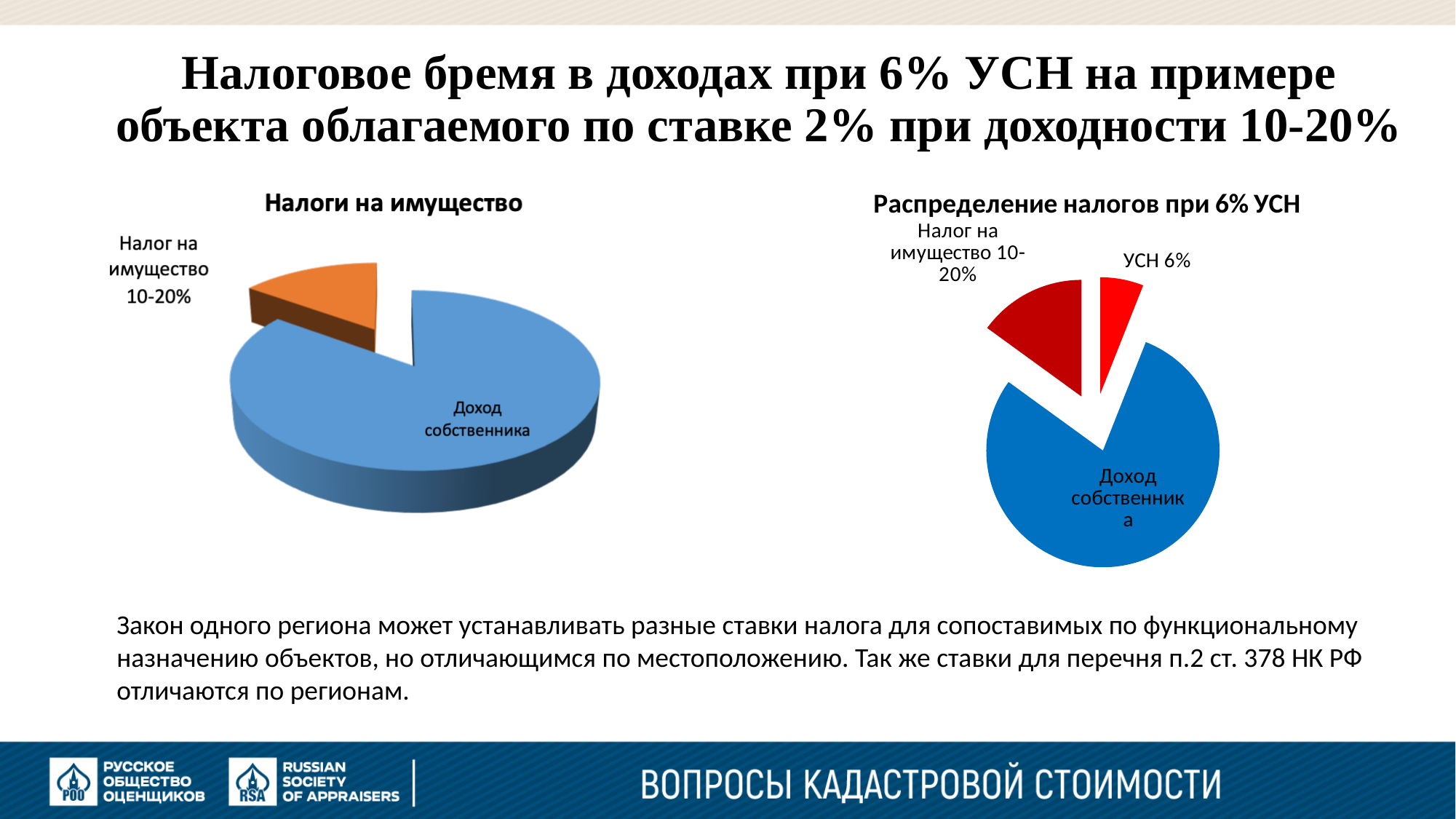
In the right chart "Распределение налогов при 6% УСН", which slice is the smallest? УСН 6% In the left chart "Налоги на имущество", which slice is larger: "Доход собственника" or "Налог на имущество 10-20%"? Доход собственника How many slices does the left chart "Налоги на имущество" have? 2 What kind of chart is the left chart titled "Налоги на имущество"? Pie chart In the right chart "Распределение налогов при 6% УСН", which slice is larger: "Налог на имущество 10-20%" or "УСН 6%"? Налог на имущество 10-20% What is the title of the chart on the right side of the slide? Распределение налогов при 6% УСН How many slices does the right chart "Распределение налогов при 6% УСН" have? 3 In the left chart "Налоги на имущество", which slice is the smallest? Налог на имущество 10-20% What kind of chart is the right chart titled "Распределение налогов при 6% УСН"? Pie chart In the left chart "Налоги на имущество", what colour is the "Налог на имущество 10-20%" slice? Orange In the right chart "Распределение налогов при 6% УСН", which slice is the largest? Доход собственника In the left chart "Налоги на имущество", which slice is the largest? Доход собственника